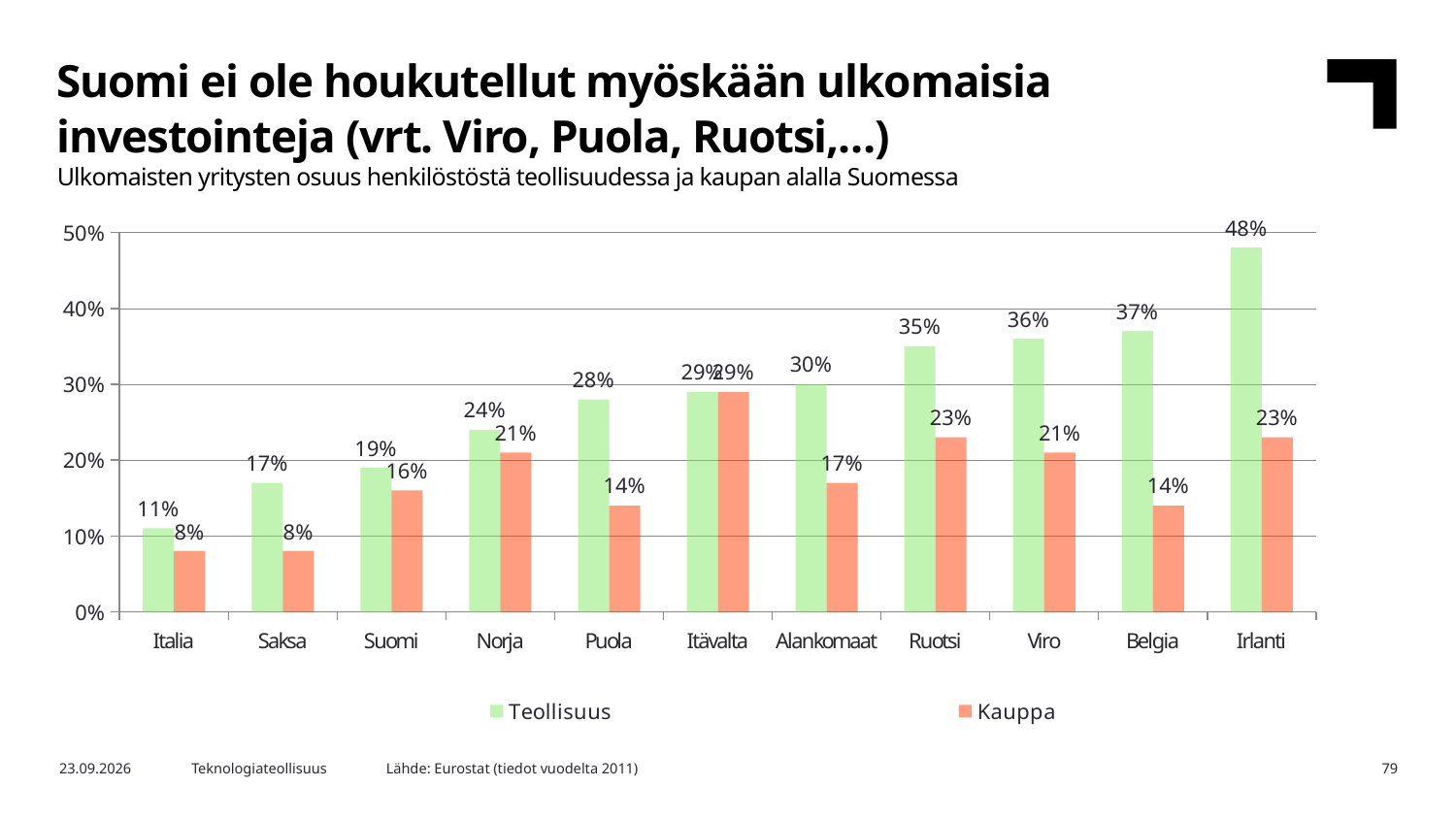
How many countries are shown on the x axis? 11 What is the Kauppa value for Ruotsi? 23% What is the difference between the Teollisuus values for Irlanti and Suomi? 29% How many series does the legend list? 2 What kind of chart is shown on the slide? Bar chart Which is larger: the Kauppa value for Norja or the Kauppa value for Puola? Norja Which country has the highest Kauppa value? Itävalta Which country has the lowest Teollisuus value? Italia Do the Teollisuus values rise or fall from Italia to Irlanti along the x axis? Rise What is the Teollisuus value for Suomi? 19% Which country has the highest Teollisuus value? Irlanti Is the Teollisuus value for Viro greater or less than 30%? greater